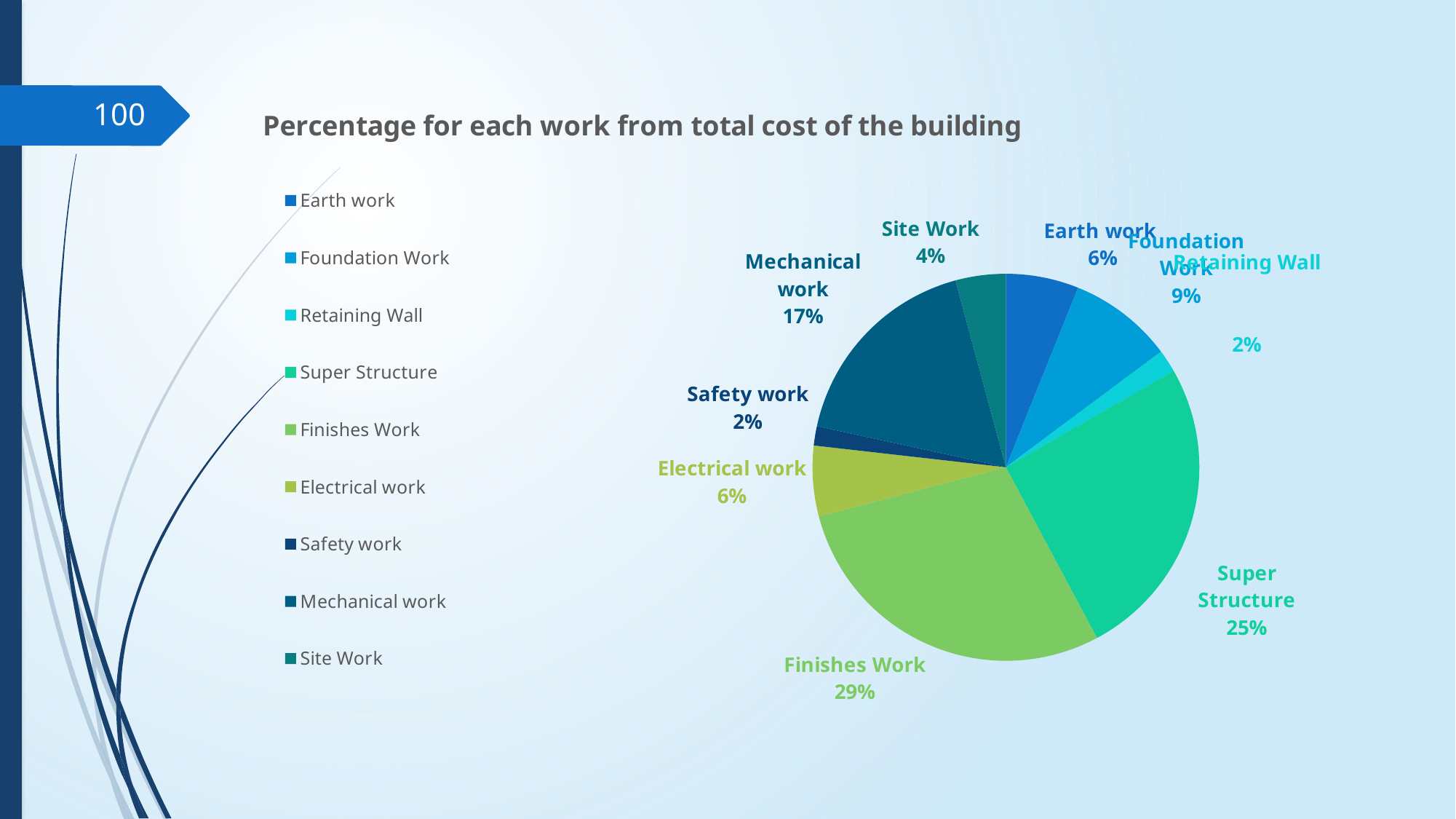
Which has a larger share of the total cost, Super Structure or Mechanical work? Super Structure What percentage of the total cost is Foundation Work? 9% What percentage of the total cost is Super Structure? 25% Which work accounts for the largest share of the total cost? Finishes Work What percentage of the total cost is Mechanical work? 17% Which has a larger share of the total cost, Foundation Work or Site Work? Foundation Work What is the title of the chart? Percentage for each work from total cost of the building What is the difference in percentage points between Finishes Work and Super Structure? 4% What percentage of the total cost is Finishes Work? 29% What percentage of the total cost is Site Work? 4% What type of chart is shown on the slide? Pie chart How many categories of work are shown in the pie chart? 9